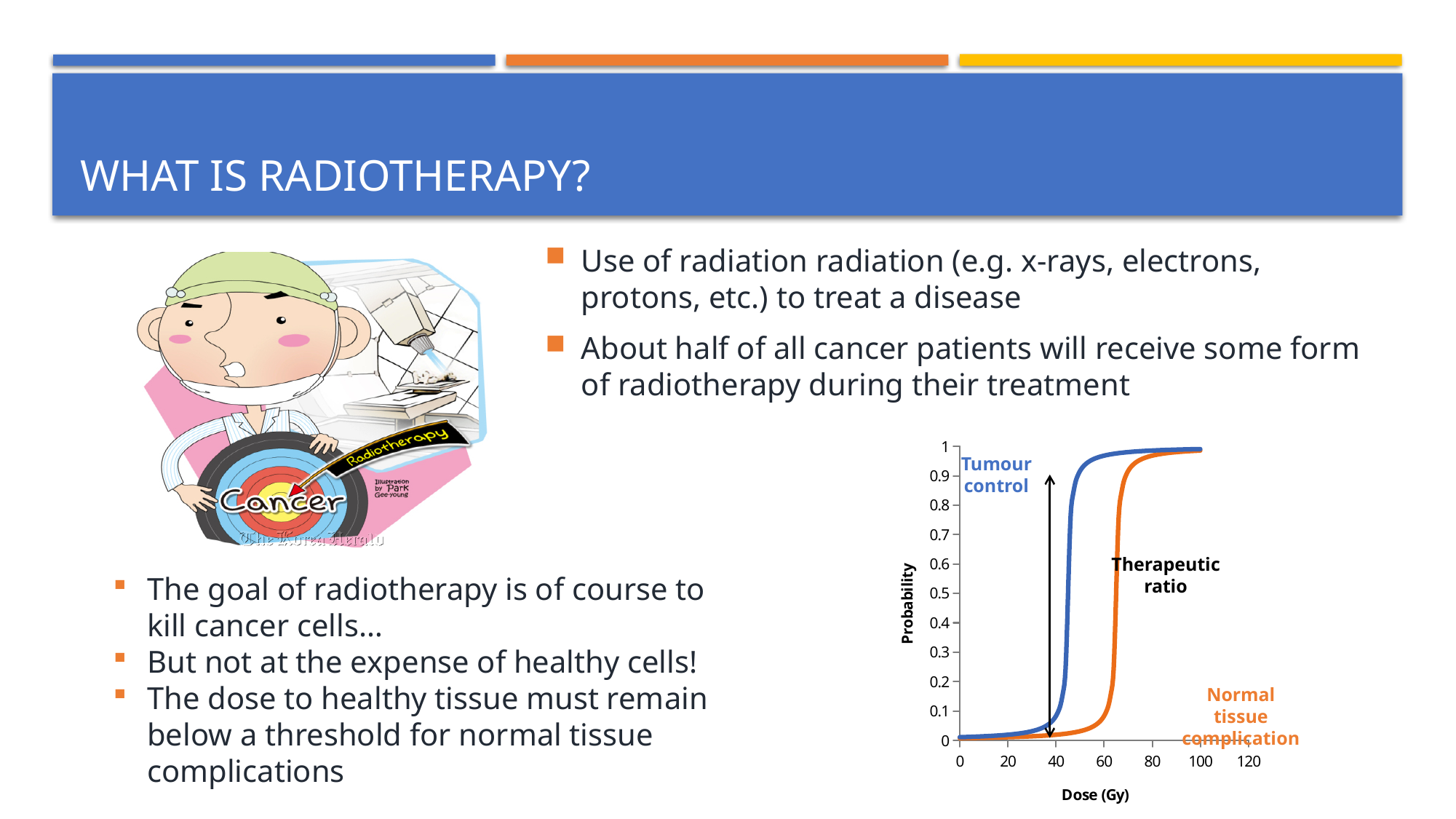
What is the title of the y axis of the chart? Probability What kind of chart is shown on the slide? line chart At a dose of 60 Gy, which curve has the higher probability, Tumour control or Normal tissue complication? Tumour control Do the probabilities rise or fall as the dose increases? rise Which curve reaches a probability of 0.5 at a lower dose, Tumour control or Normal tissue complication? Tumour control At a dose of 80 Gy, is the Normal tissue complication probability greater or less than 0.9? greater At a dose of 40 Gy, is the Normal tissue complication probability greater or less than 0.1? less How many tick labels are shown on the x axis of the chart? 7 What is the title of the x axis of the chart? Dose (Gy) At a dose of 60 Gy, is the Tumour control probability greater or less than 0.9? greater How many curves are plotted on the chart? 2